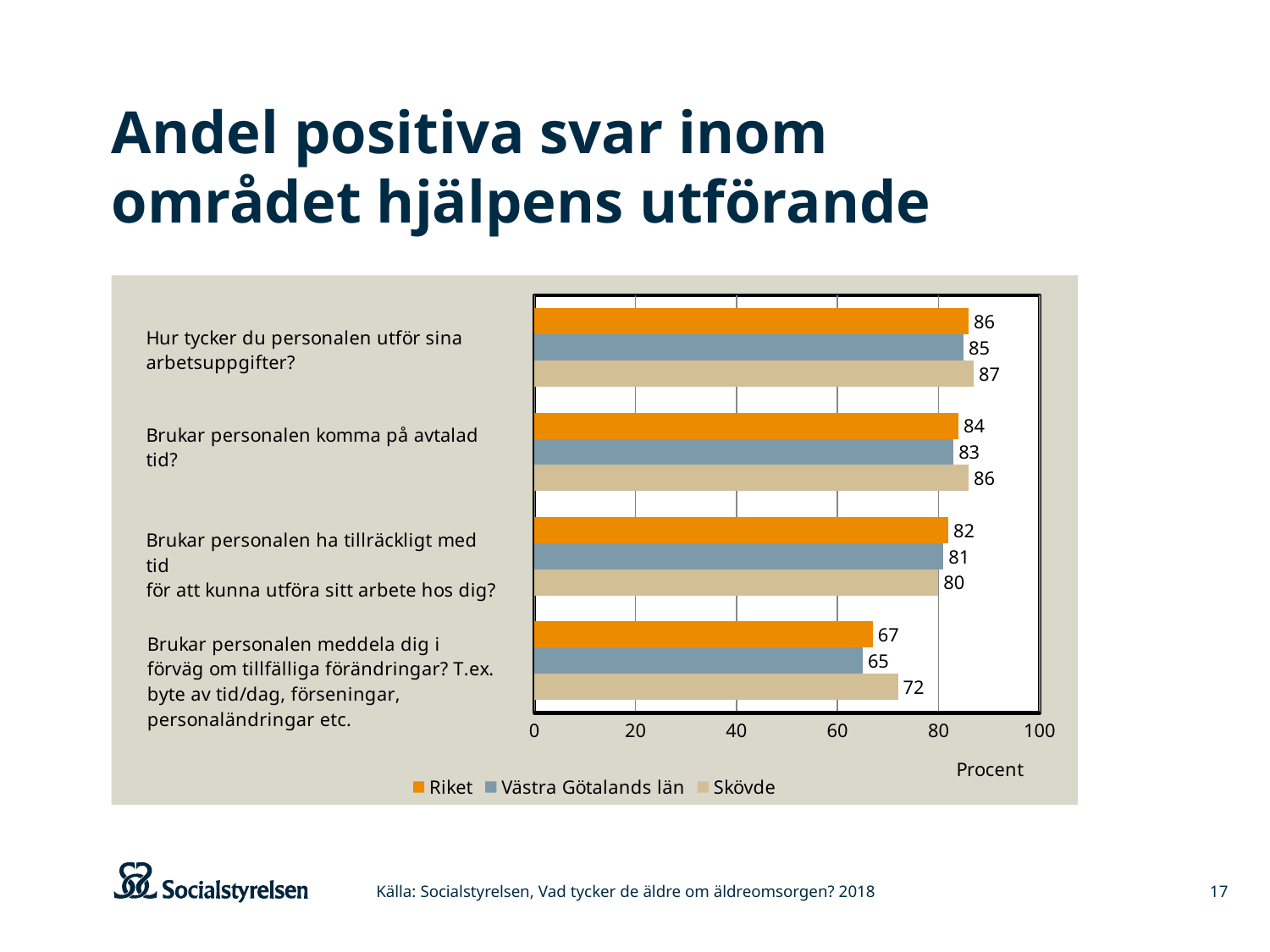
Which question has the highest value for Skövde? Hur tycker du personalen utför sina arbetsuppgifter? What is the value for Riket on "Hur tycker du personalen utför sina arbetsuppgifter?"? 86 What is the value for Skövde on "Brukar personalen ha tillräckligt med tid för att kunna utföra sitt arbete hos dig?"? 80 What is the label on the horizontal axis of the chart? Procent How many questions (categories) are shown in the chart? 4 What is the value for Skövde on "Brukar personalen meddela dig i förväg om tillfälliga förändringar?"? 72 What is the difference between Skövde and Västra Götalands län on "Brukar personalen meddela dig i förväg om tillfälliga förändringar?"? 7 On "Brukar personalen komma på avtalad tid?", which is larger: Riket or Skövde? Skövde What kind of chart is shown on the slide? Bar chart How many series does the legend list? 3 Which question has the lowest value for Riket? Brukar personalen meddela dig i förväg om tillfälliga förändringar? What is the value for Västra Götalands län on "Brukar personalen komma på avtalad tid?"? 83